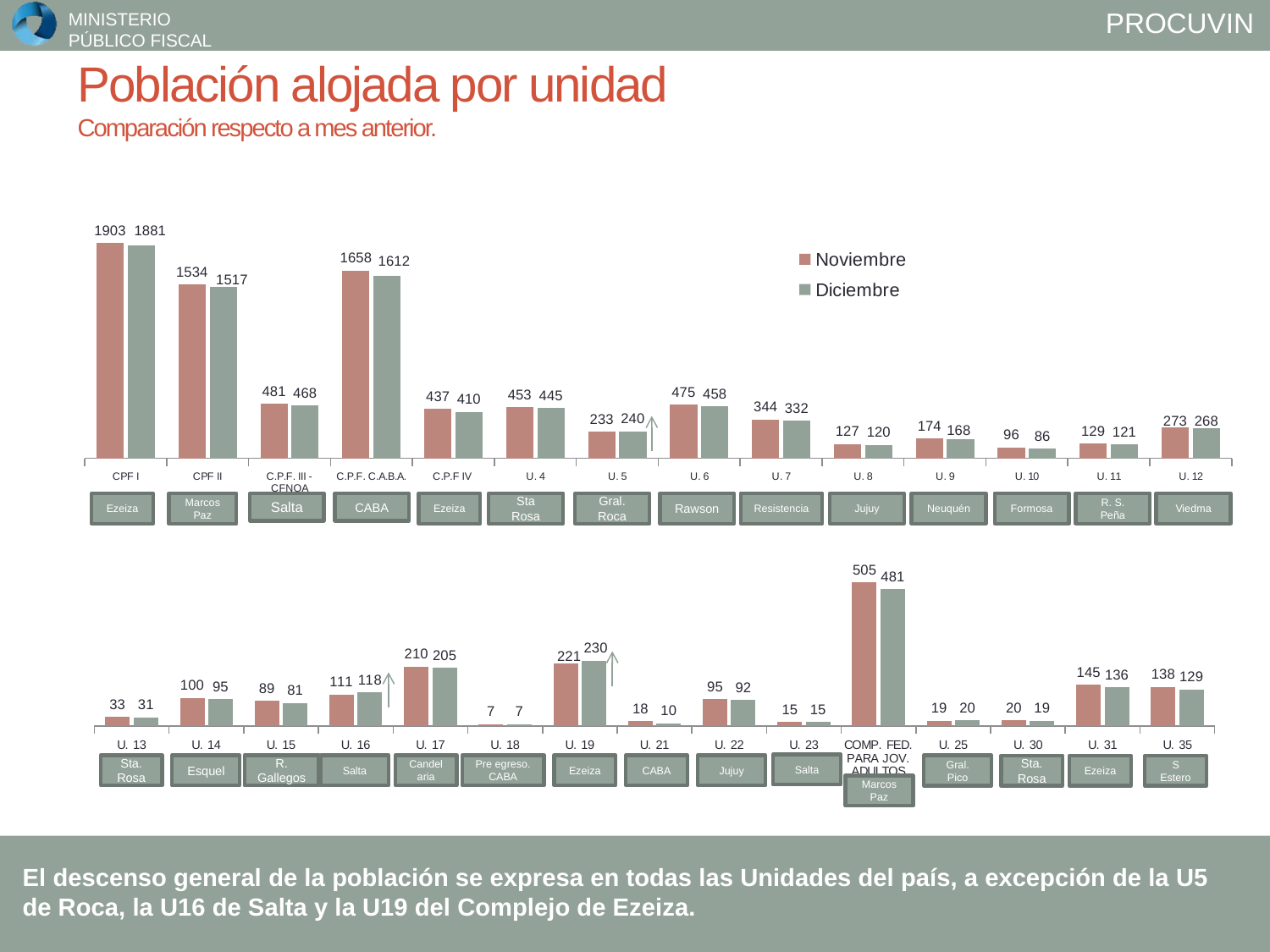
How many series does the legend list? 2 In the top chart, what is the Noviembre value for CPF I? 1903 In the bottom chart, what is the Diciembre value for U. 19? 230 In the bottom chart, is the Noviembre value for U. 16 larger or smaller than its Diciembre value? Smaller In the bottom chart, what is the difference between the Noviembre and Diciembre values for U. 21? 8 In the bottom chart, which category has the highest Noviembre value? COMP. FED. PARA JOV. ADULTOS In the top chart, which category has the lowest Noviembre value? U. 10 In the top chart, what is the Diciembre value for U. 5? 240 What type of chart is the bottom chart? Bar chart In the top chart, what is the difference between the Noviembre and Diciembre values for C.P.F. C.A.B.A.? 46 In the top chart, which category has the highest Diciembre value? CPF I In the top chart, how many categories are shown on the x axis? 14